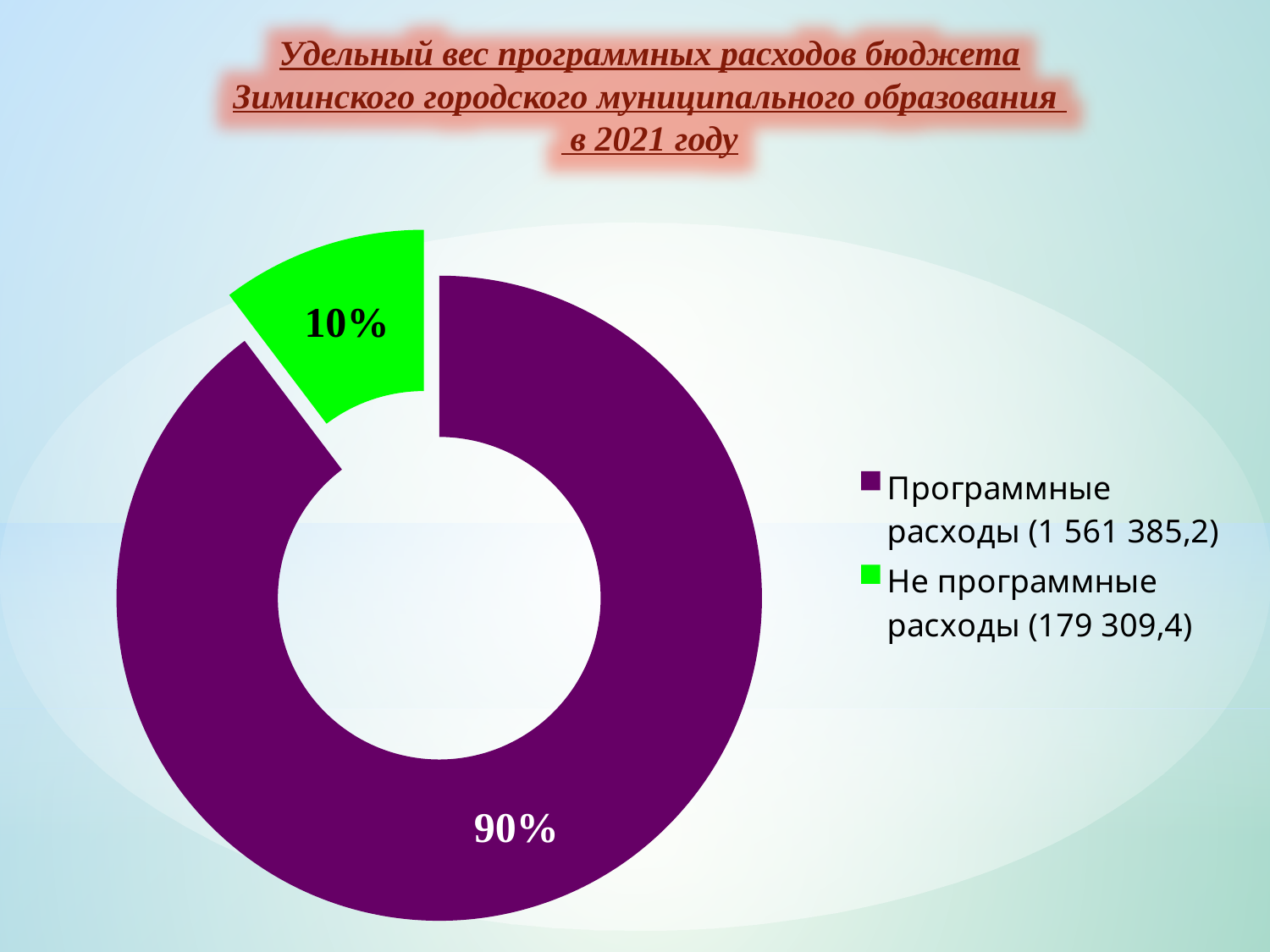
How many categories are shown in the chart? 2 What amount is shown in the legend for 'Программные расходы'? 1 561 385,2 What kind of chart is shown on the slide? Doughnut (pie) chart How many entries does the legend list? 2 What share of the chart does the 'Не программные расходы' slice represent? 10% What colour is the 'Не программные расходы' slice? Green Which category has the smallest share in the chart? Не программные расходы What share of the chart does the 'Программные расходы' slice represent? 90% Which category has the largest share in the chart? Программные расходы What amount is shown in the legend for 'Не программные расходы'? 179 309,4 Which is larger: the share for 'Программные расходы' or for 'Не программные расходы'? Программные расходы What is the difference in percentage points between the 'Программные расходы' and 'Не программные расходы' shares? 80